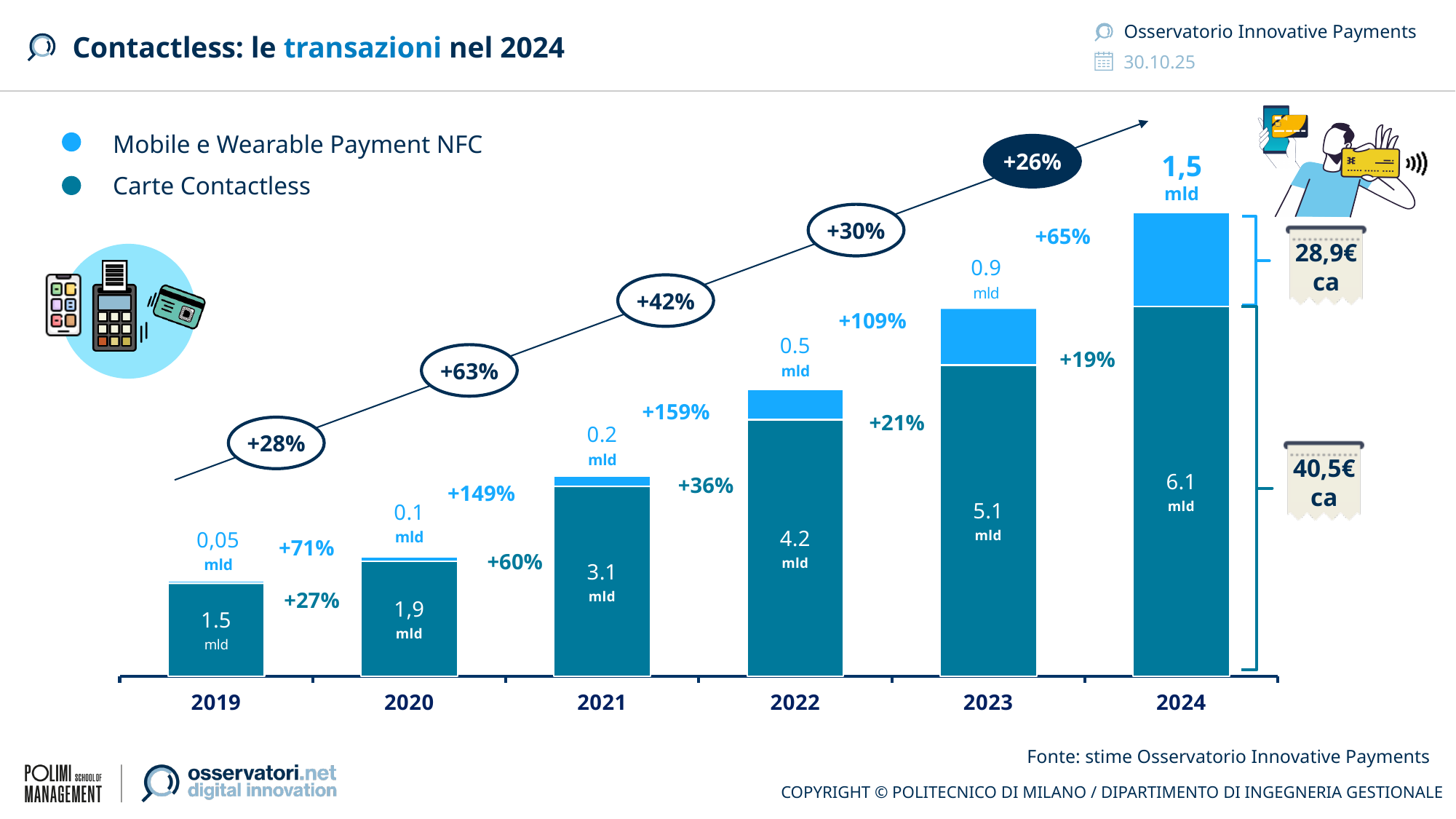
What is the difference between the Carte Contactless values for 2023 and 2022? 0.9 mld What is the total growth percentage shown in the oval between 2023 and 2024? +26% What is the value for Carte Contactless in 2020? 1,9 mld Which is larger: Carte Contactless in 2021 or Mobile e Wearable Payment NFC in 2024? Carte Contactless in 2021 What kind of chart is shown on the slide? Stacked bar chart What is the value for Mobile e Wearable Payment NFC in 2023? 0.9 mld Which year has the highest value for Carte Contactless? 2024 Which year has the lowest value for Mobile e Wearable Payment NFC? 2019 What is the value for Mobile e Wearable Payment NFC in 2019? 0,05 mld How many years are shown on the x axis? 6 How many series does the legend list? 2 What is the value for Carte Contactless in 2024? 6.1 mld